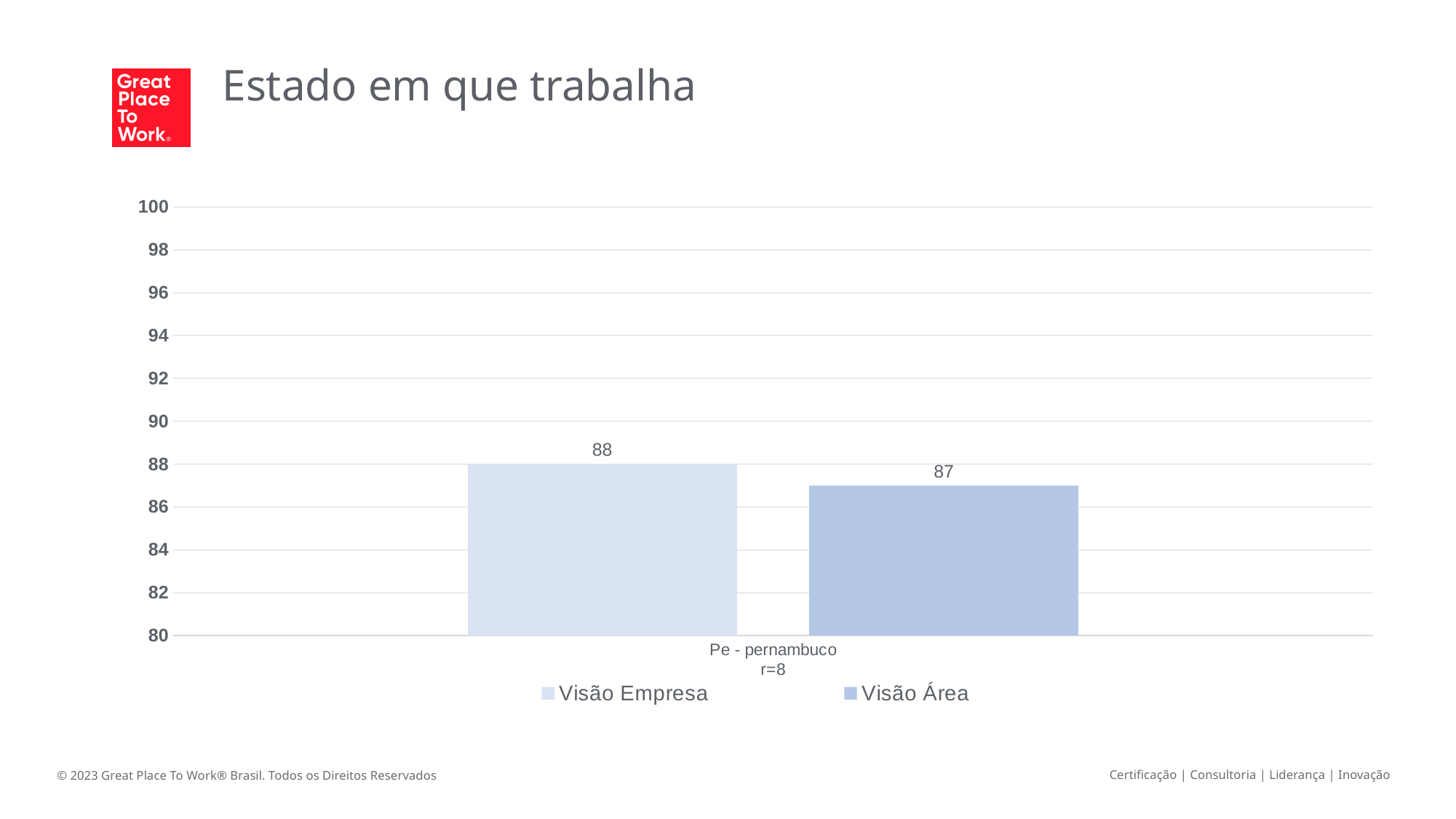
How many categories are shown on the x axis? 1 What is the title of the slide? Estado em que trabalha Is the value for Visão Área greater or less than 90? less How many series does the legend list? 2 Which series has the higher value for Pe - pernambuco, Visão Empresa or Visão Área? Visão Empresa Is the value for Visão Empresa greater or less than 84? greater What is the difference between the Visão Empresa and Visão Área values for Pe - pernambuco? 1 What is the label of the category on the x axis? Pe - pernambuco r=8 What is the value for Visão Empresa for Pe - pernambuco? 88 What is the lowest value shown on the y axis? 80 What is the value for Visão Área for Pe - pernambuco? 87 What kind of chart is shown on the slide? bar chart